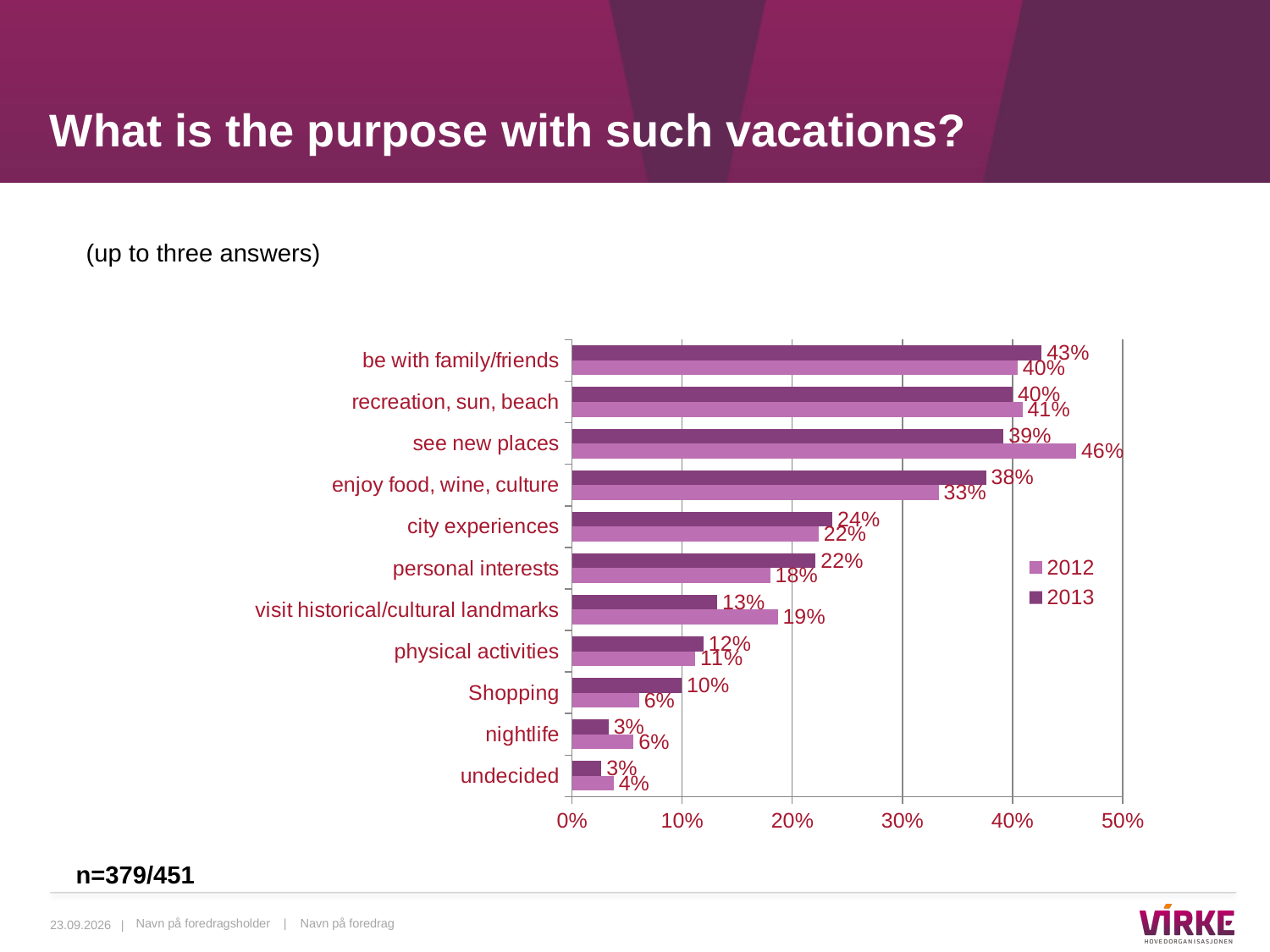
For "Shopping", which year has the larger value, 2012 or 2013? 2013 What is the 2012 value for "see new places"? 46% What is the 2012 value for "visit historical/cultural landmarks"? 19% How many series does the legend list? 2 Which category has the highest 2012 value? see new places What kind of chart is shown on the slide? bar chart For "nightlife", which year has the larger value, 2012 or 2013? 2012 Which category has the highest 2013 value? be with family/friends How many categories are shown on the chart? 11 What is the difference between the 2012 and 2013 values for "see new places"? 7% What is the difference between the 2013 and 2012 values for "enjoy food, wine, culture"? 5% What is the 2013 value for "be with family/friends"? 43%